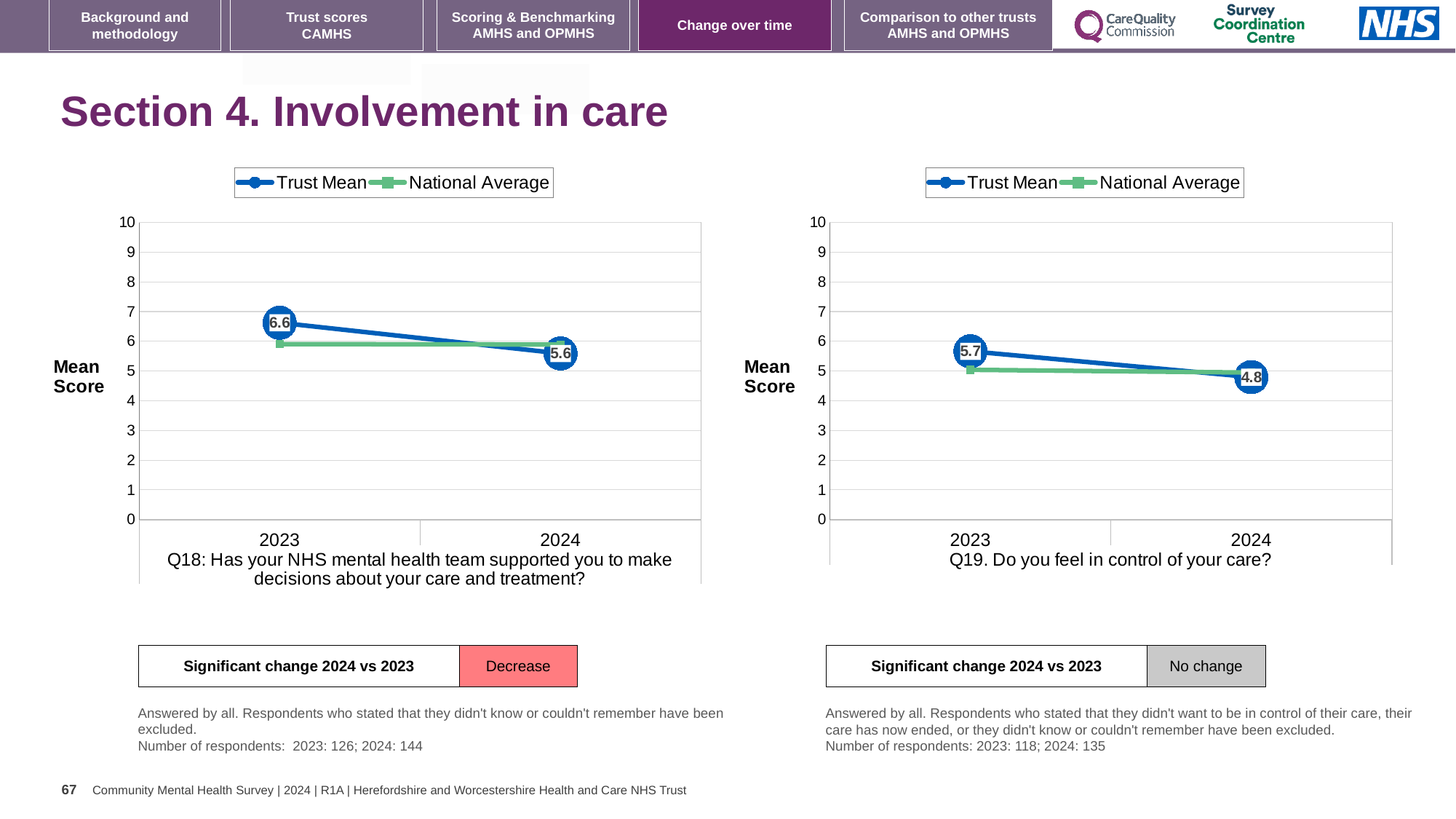
In the Q18 chart on the left, by how much did the Trust Mean change from 2023 to 2024? 1.0 What kind of chart is the Q19 chart on the right? line chart In the Q18 chart on the left, what is the Trust Mean score for 2024? 5.6 How many series does the legend of the Q18 chart on the left list? 2 In the Q19 chart on the right, is the Trust Mean for 2024 greater or less than 5? less In the Q18 chart on the left, what is the Trust Mean score for 2023? 6.6 How many years are plotted on the x axis of the Q19 chart on the right? 2 In the Q19 chart on the right, what is the Trust Mean score for 2023? 5.7 In the Q18 chart on the left, does the Trust Mean rise or fall from 2023 to 2024? fall In the Q18 chart on the left, which year has the higher Trust Mean, 2023 or 2024? 2023 In the Q19 chart on the right, what is the Trust Mean score for 2024? 4.8 In the Q19 chart on the right, what is the difference between the Trust Mean in 2023 and in 2024? 0.9